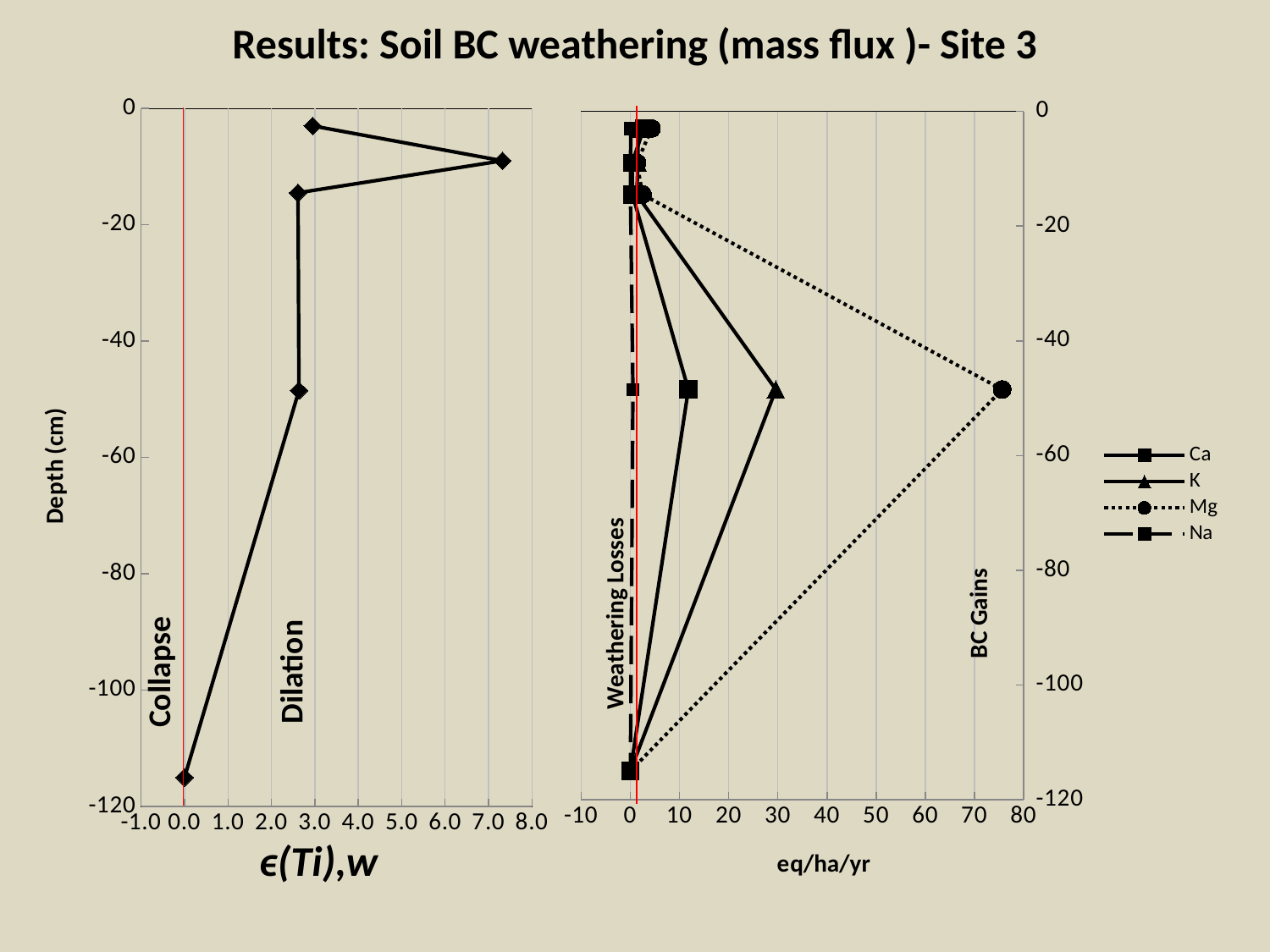
On the left chart (ε(Ti),w), is the value at a depth of about -9 cm greater or less than 5.0? greater What kind of chart is the left chart (ε(Ti),w versus depth)? line chart On the left chart (ε(Ti),w), is the value at a depth of about -49 cm greater or less than 2.0? greater On the right chart (eq/ha/yr), is the Ca value at a depth of about -49 cm greater or less than 20? less Which series are listed in the legend of the right chart (eq/ha/yr)? Ca, K, Mg, Na What is the x-axis label of the right chart? eq/ha/yr On the right chart (eq/ha/yr), which series stays lowest, closest to zero, across all depths? Na How many series does the legend of the right chart (eq/ha/yr) list? 4 On the right chart (eq/ha/yr), which series reaches the highest value? Mg On the right chart (eq/ha/yr), at a depth of about -49 cm, which is larger: the K value or the Ca value? K How many data points are plotted on the left chart (ε(Ti),w versus depth)? 5